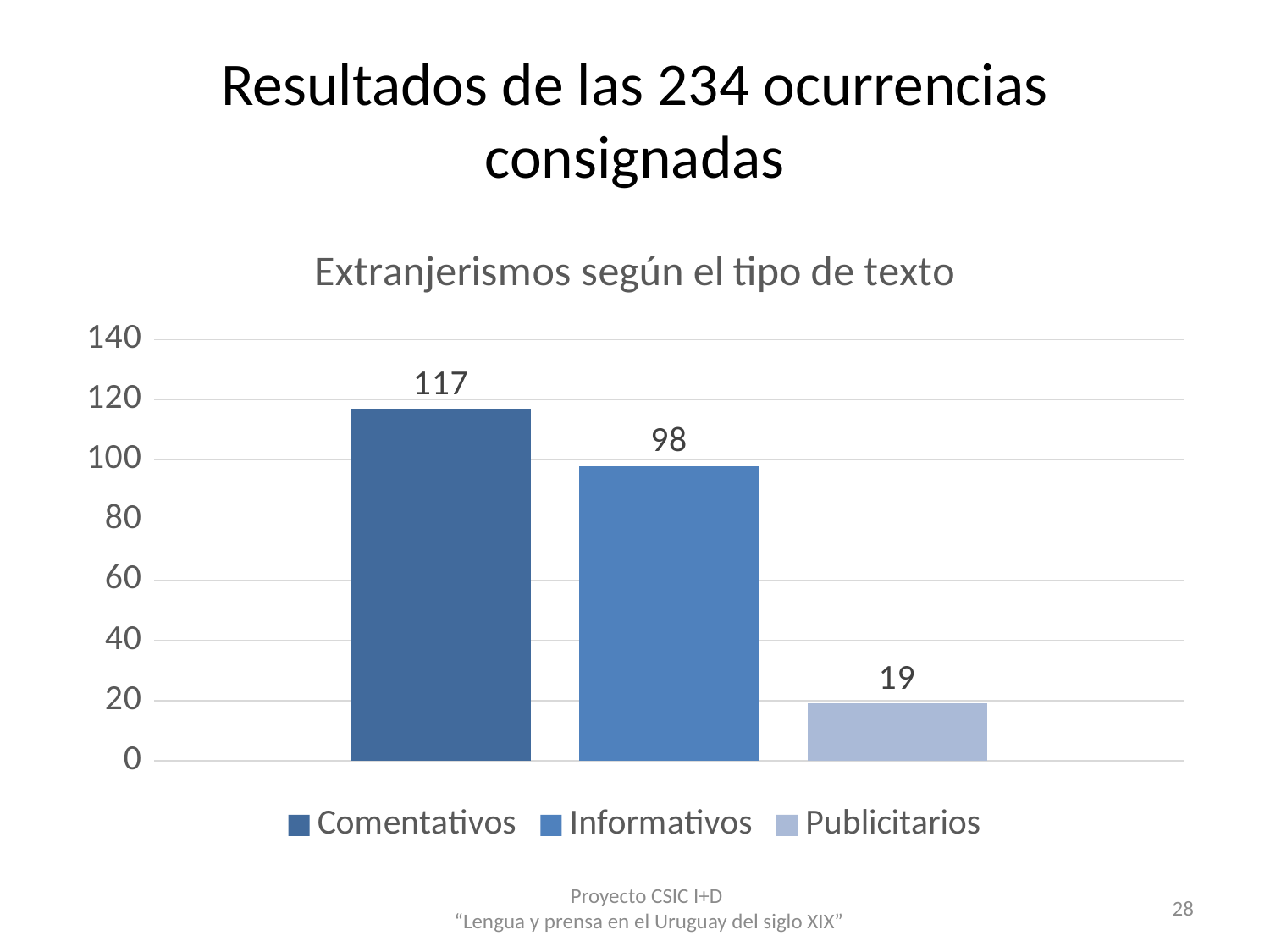
What kind of chart is shown on the slide? bar chart What is the value for Comentativos? 117 What is the value for Publicitarios? 19 What is the value for Informativos? 98 Which category has the highest value? Comentativos Which is larger, the value for Informativos or the value for Publicitarios? Informativos Is the value for Informativos greater or less than 100? less What is the difference between the values for Comentativos and Informativos? 19 Which category has the lowest value? Publicitarios What is the difference between the values for Informativos and Publicitarios? 79 How many bars are shown in the chart? 3 What is the title of the chart? Extranjerismos según el tipo de texto